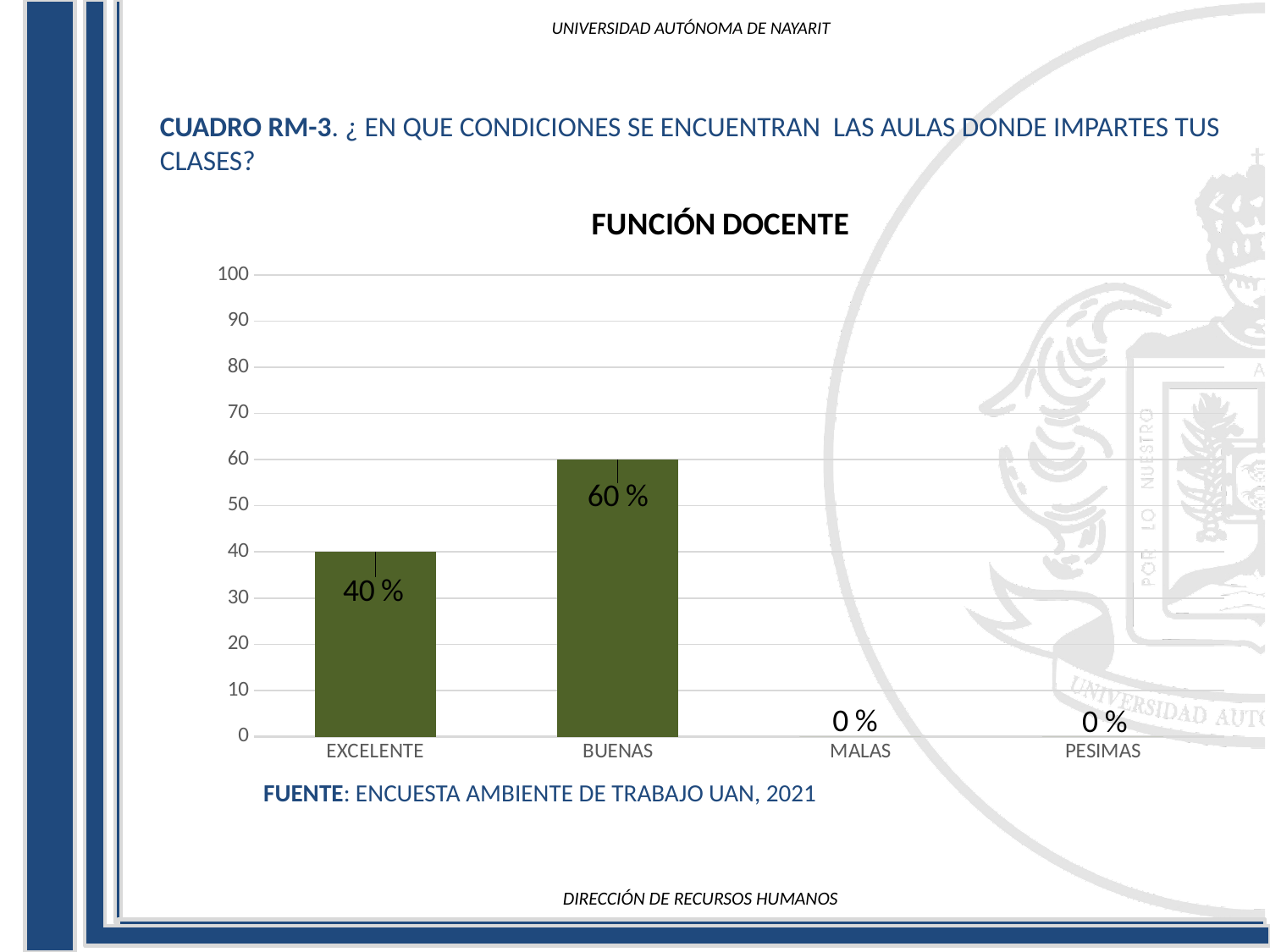
Which is larger, the value for EXCELENTE or the value for BUENAS? BUENAS Which category has the highest value? BUENAS What is the value for MALAS? 0 % Is the value for EXCELENTE greater or less than 50? less Is the value for BUENAS greater or less than 50? greater What is the value for EXCELENTE? 40 % What is the title of the chart? FUNCIÓN DOCENTE What is the difference between the values for BUENAS and EXCELENTE? 20 % How many categories are shown on the x axis? 4 What kind of chart is shown? bar chart What is the value for BUENAS? 60 % What is the value for PESIMAS? 0 %